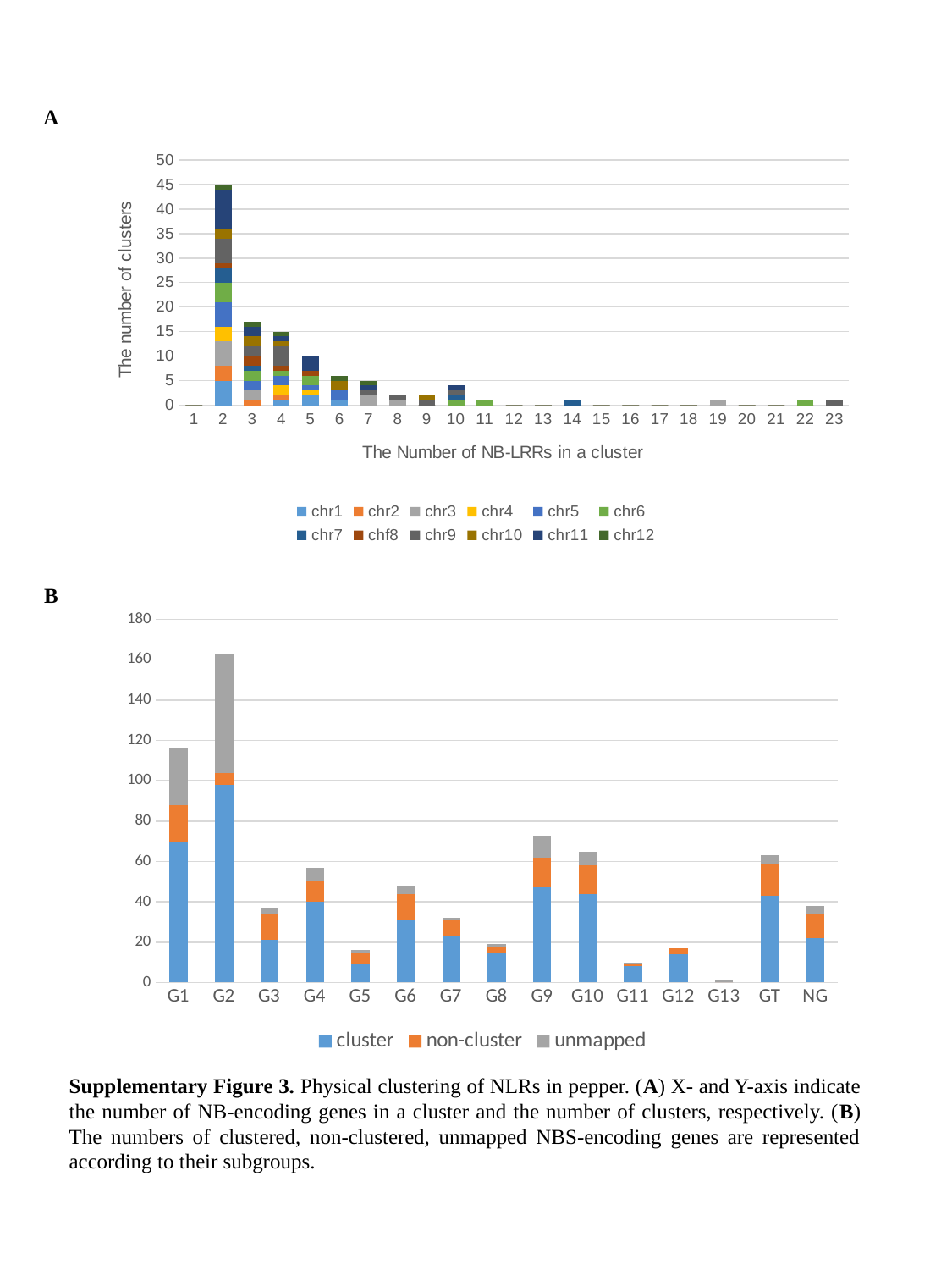
In chart B (the bottom chart), which subgroup has the tallest bar? G2 In chart B (the bottom chart), which subgroup has the shortest bar? G13 In chart B (the bottom chart), which has the taller bar, G3 or G4? G4 In chart A (the top chart), which x-axis category has the tallest bar? 2 In chart B (the bottom chart), how many series does the legend list? 3 In chart A (the top chart), is the total bar height for category 2 greater or less than 40? greater In chart A (the top chart), how many categories are shown on the x axis? 23 In chart A (the top chart), from category 2 to category 7, do the bar heights rise or fall? fall In chart A (the top chart), what is the y-axis title? The number of clusters What kind of chart is chart A (the top chart)? Stacked bar chart In chart A (the top chart), how many series does the legend list? 12 In chart B (the bottom chart), is the total bar height for G1 greater or less than 100? greater